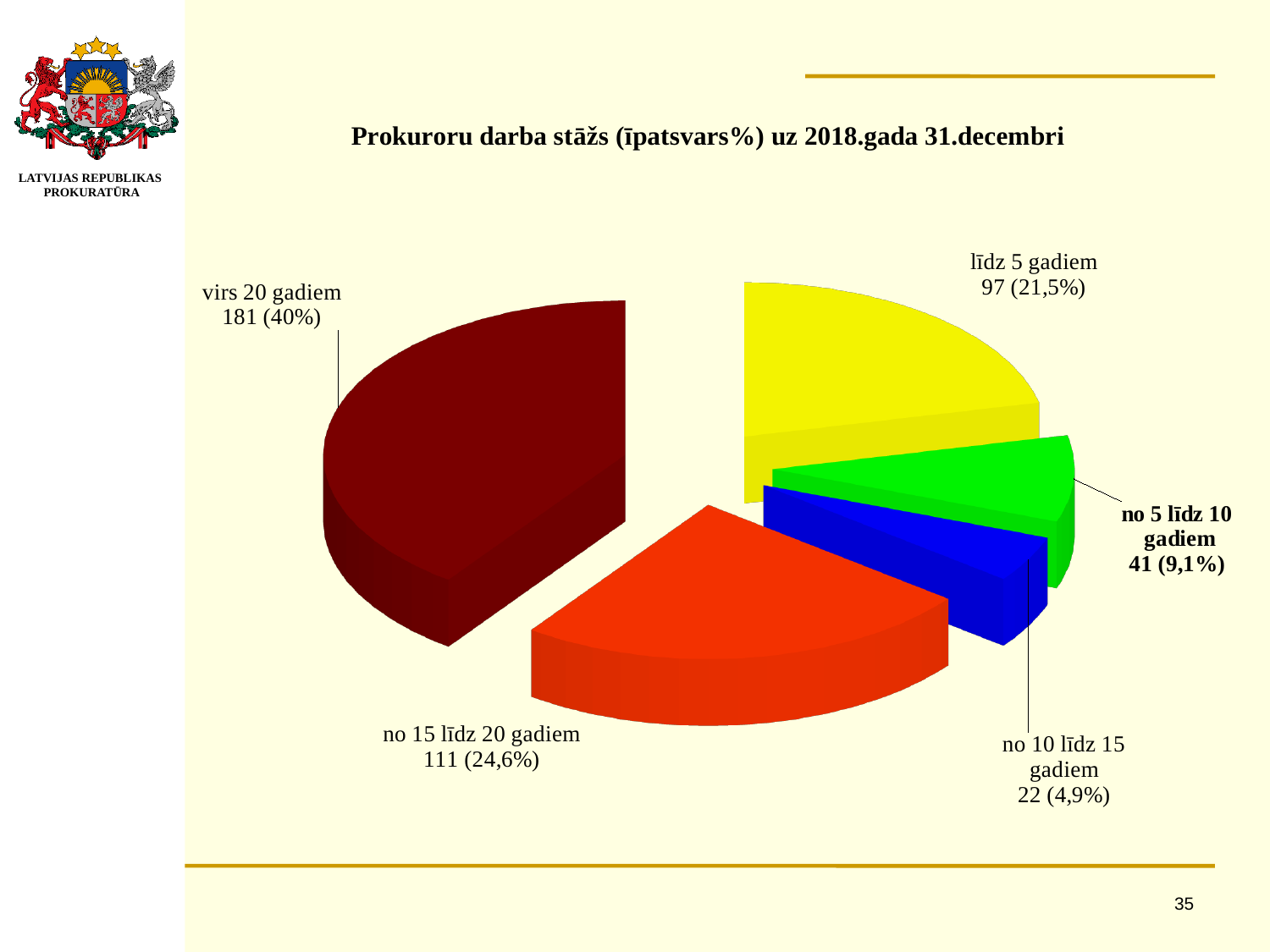
Which category has the smallest slice? no 10 līdz 15 gadiem What is the value shown for "virs 20 gadiem"? 181 (40%) Which category has the largest slice? virs 20 gadiem What is the difference in count between "virs 20 gadiem" and "no 15 līdz 20 gadiem"? 70 What share of the pie does "no 15 līdz 20 gadiem" represent? 24,6% What is the value shown for "no 10 līdz 15 gadiem"? 22 (4,9%) What kind of chart is shown on the slide? pie chart What is the value shown for "līdz 5 gadiem"? 97 (21,5%) Which is larger, "līdz 5 gadiem" or "no 5 līdz 10 gadiem"? līdz 5 gadiem What share of the pie does "no 5 līdz 10 gadiem" represent? 9,1% What is the title of the chart? Prokuroru darba stāžs (īpatsvars%) uz 2018.gada 31.decembri How many slices does the pie chart have? 5